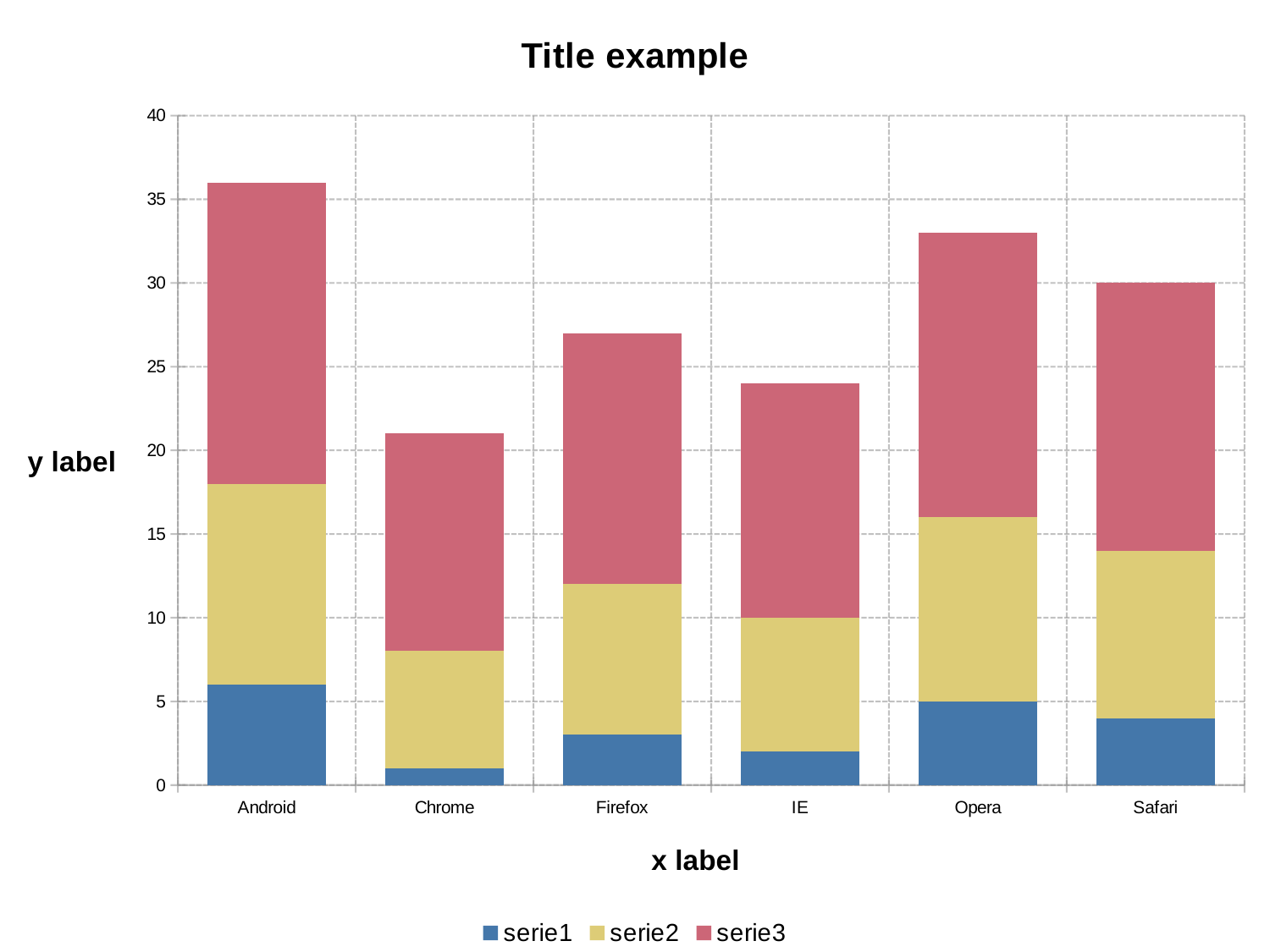
What is the serie1 value for Opera? 5 Is the total stacked bar for IE greater or less than 25? less How many categories are shown on the x axis? 6 Which category has the shortest stacked bar? Chrome What kind of chart is shown on the slide? stacked bar chart Which stacked bar is taller, Opera or Firefox? Opera Is the total stacked bar for Android greater or less than 35? greater Which series is shown in blue in the legend? serie1 How many series does the legend list? 3 What is the total height of the stacked bar for Safari? 30 Which category has the tallest stacked bar? Android What is the title of the chart? Title example